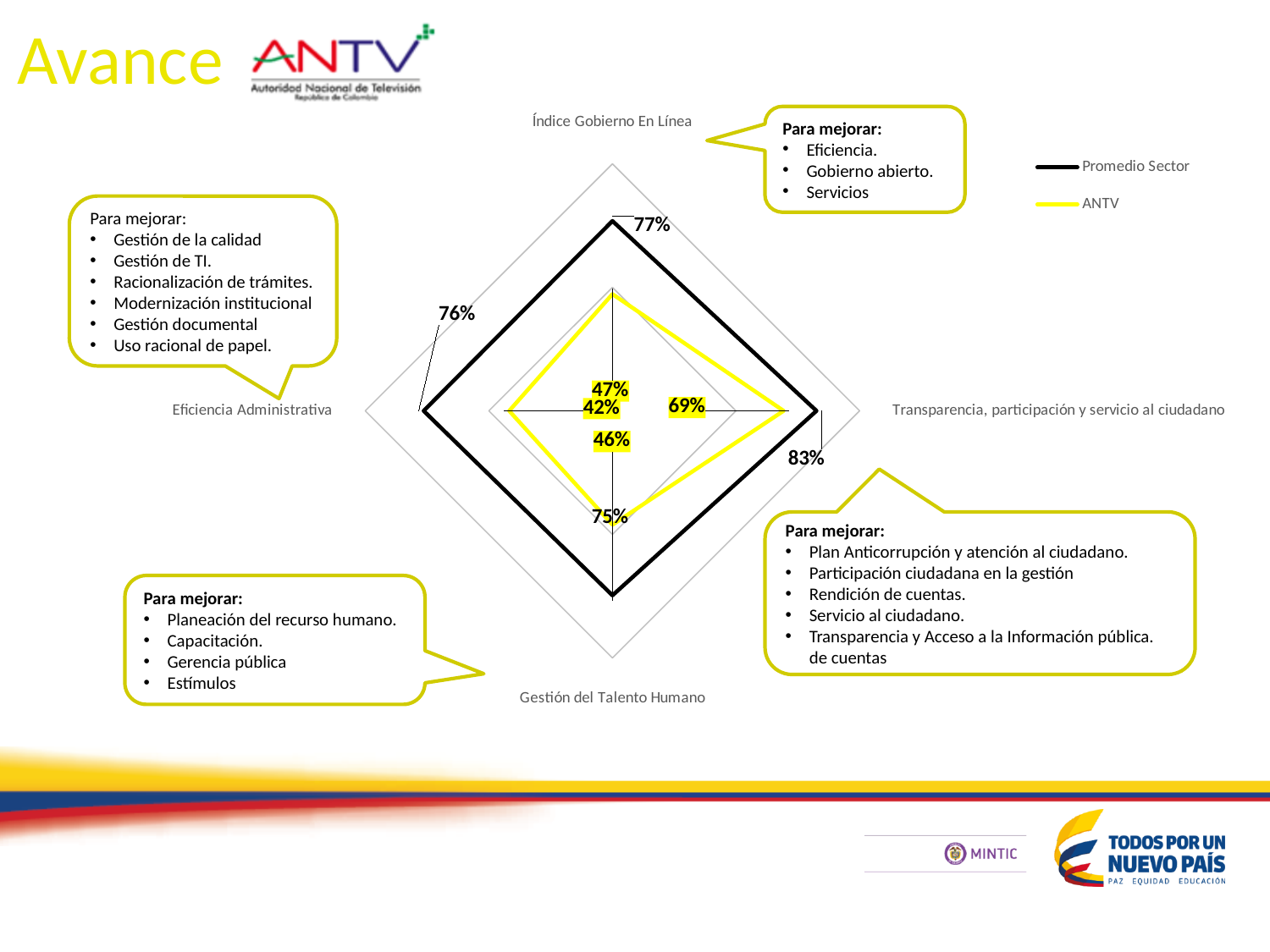
What is the ANTV value for Índice Gobierno En Línea? 47% What kind of chart is shown on the slide? Radar chart What is the difference between the Promedio Sector and ANTV values for Eficiencia Administrativa? 34% Which series has the larger value for Gestión del Talento Humano, Promedio Sector or ANTV? Promedio Sector How many series does the chart legend list? 2 What is the Promedio Sector value for Transparencia, participación y servicio al ciudadano? 83% In which category does ANTV have its highest value? Transparencia, participación y servicio al ciudadano What is the ANTV value for Eficiencia Administrativa? 42% Which colour represents the ANTV series in the chart? Yellow In which category does ANTV have its lowest value? Eficiencia Administrativa What is the Promedio Sector value for Gestión del Talento Humano? 75% How many categories (axes) does the radar chart have? 4